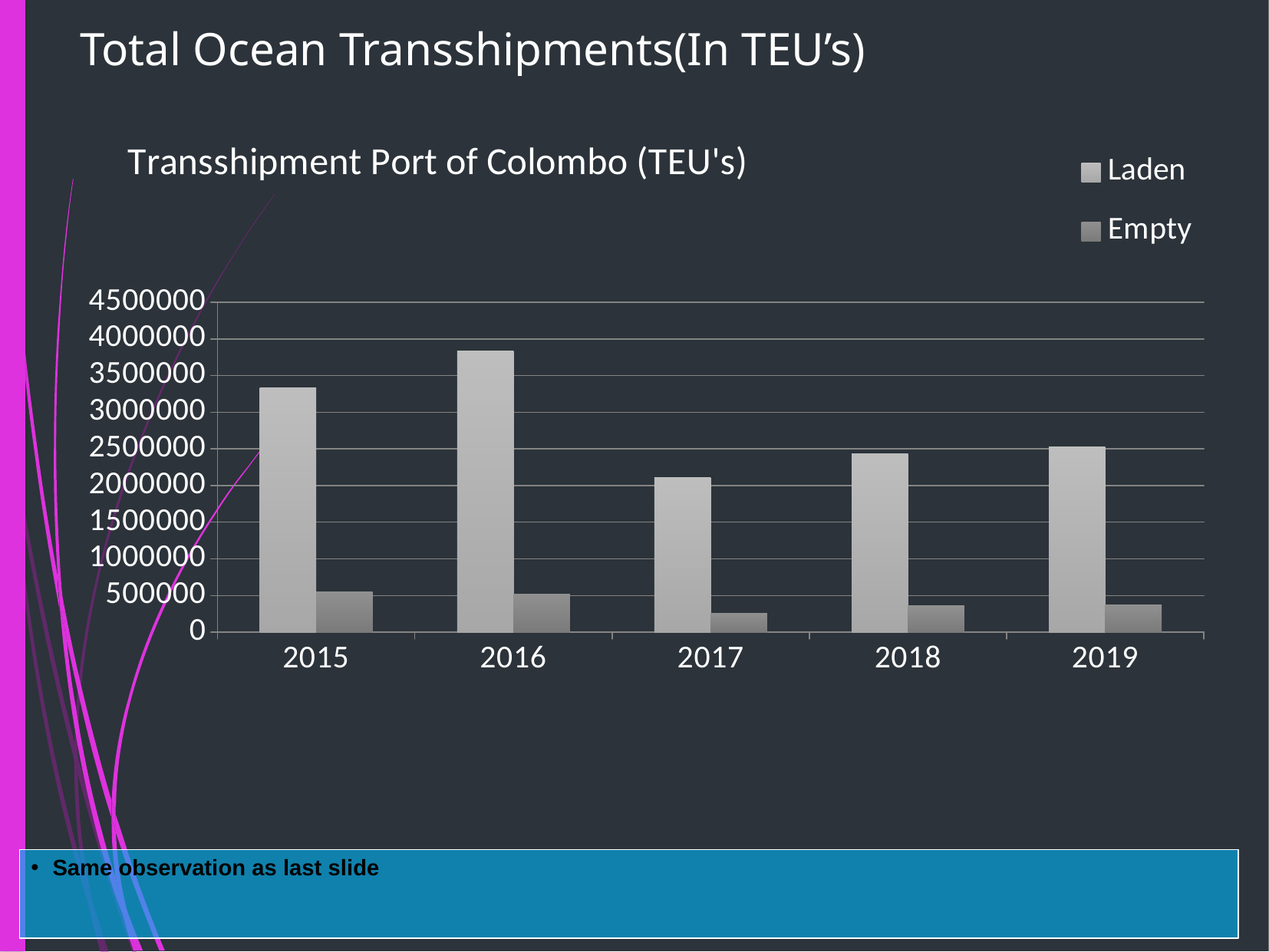
Which year has the lowest Laden value? 2017 Is the Laden value for 2015 greater or less than 3000000? greater Which year has the highest Laden value? 2016 What kind of chart is shown on the slide? bar chart Is the Laden value for 2016 greater or less than 3500000? greater Which year has the lowest Empty value? 2017 Is the Empty value for 2017 greater or less than 500000? less How many years are shown on the x axis of the chart? 5 What is the title of the chart? Transshipment Port of Colombo (TEU's) How many series does the chart's legend list? 2 Which is larger, the Laden value for 2015 or the Laden value for 2016? 2016